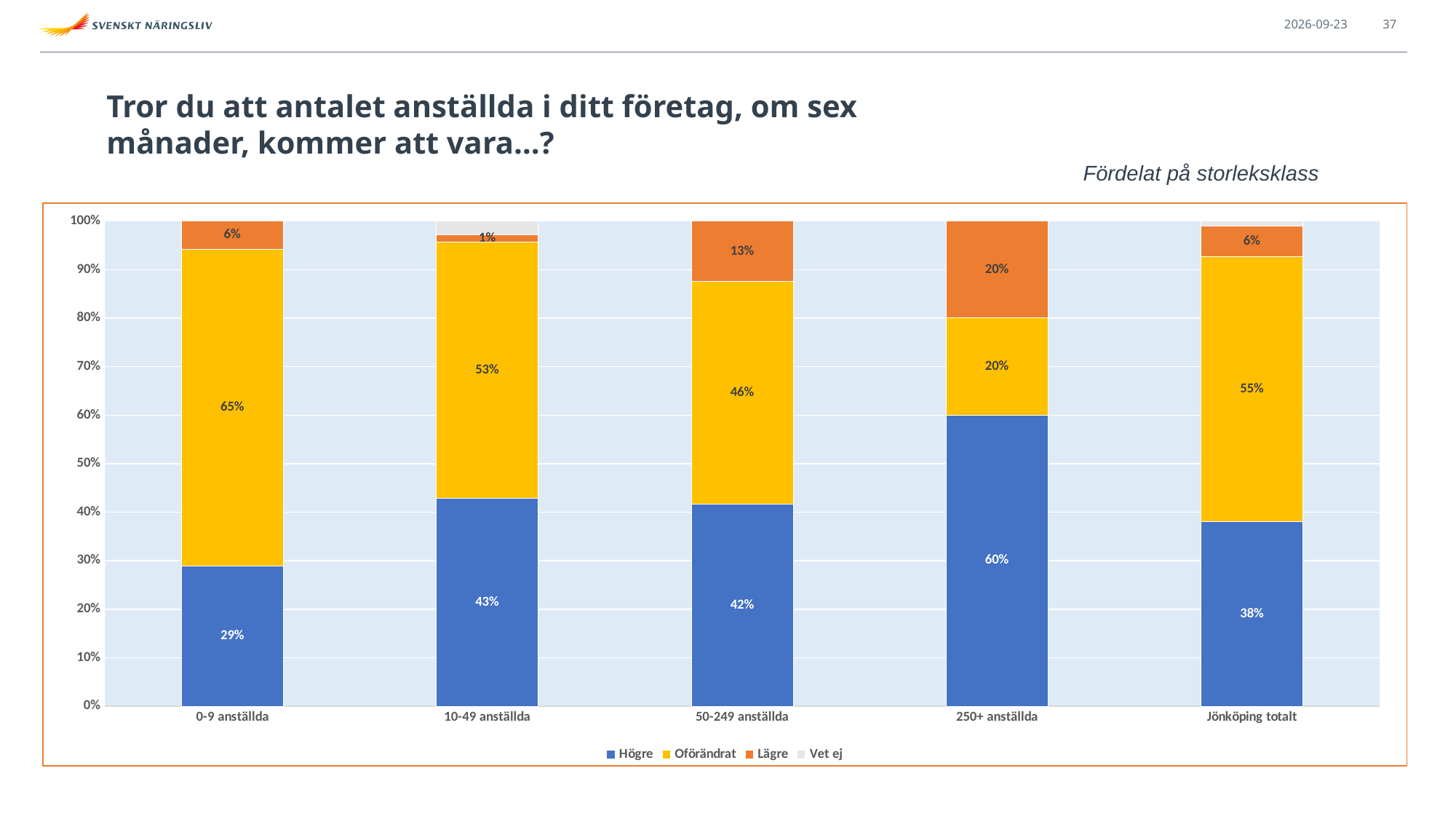
What kind of chart is shown on the slide? Stacked bar chart What is the difference between the Oförändrat values for 0-9 anställda and 10-49 anställda? 12% What is the Högre value for 250+ anställda? 60% Which is larger: the Lägre value for 250+ anställda or the Lägre value for 0-9 anställda? 250+ anställda How many size classes are shown on the x axis? 5 What is the Högre value for Jönköping totalt? 38% What is the Lägre value for 50-249 anställda? 13% What is the Oförändrat value for 0-9 anställda? 65% Is the Högre value for 10-49 anställda greater or less than 40%? greater Which size class has the lowest Högre share? 0-9 anställda How many series does the legend list? 4 Which size class has the highest Högre share? 250+ anställda